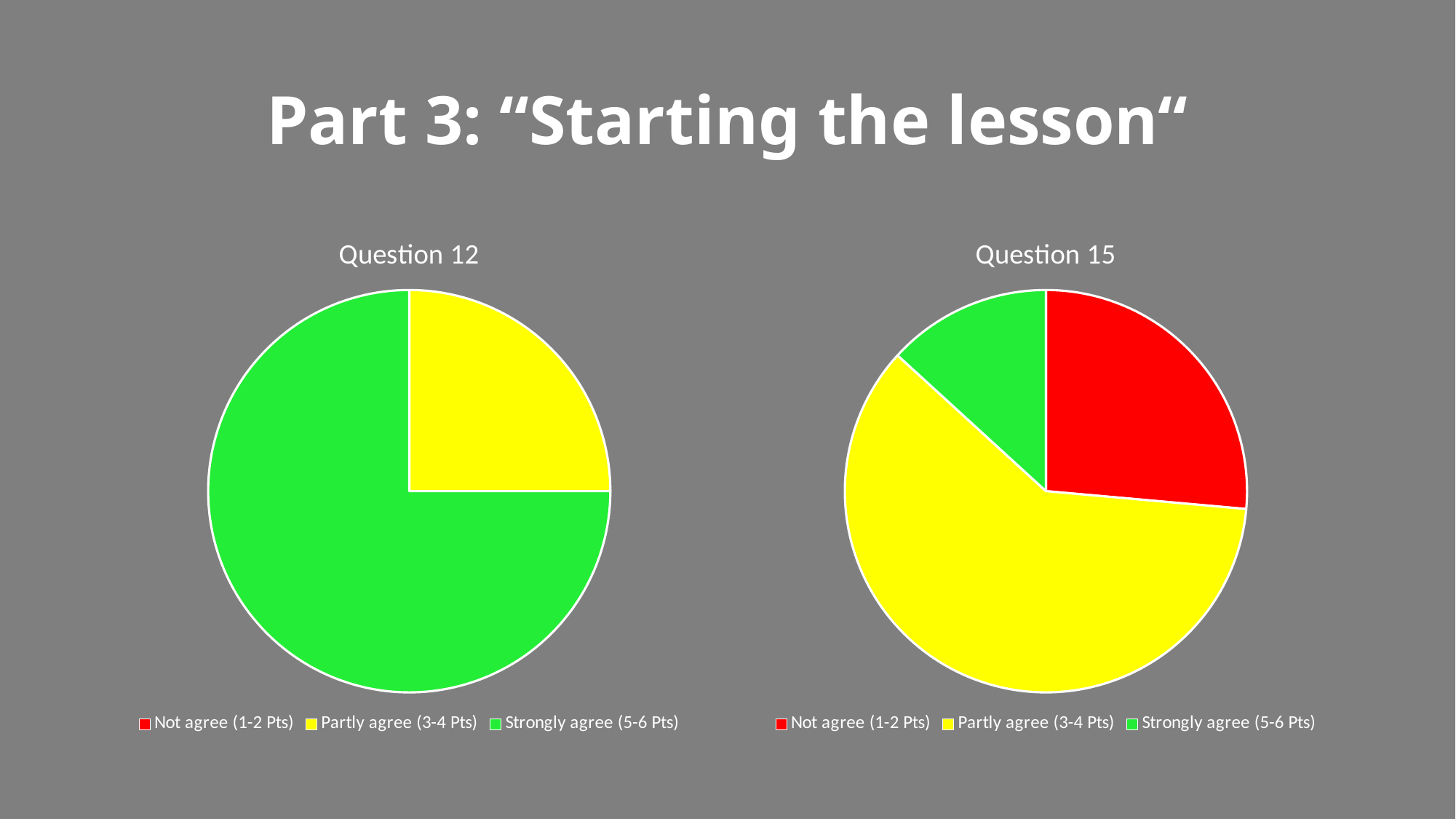
In the "Question 15" chart, which is larger: the slice for Not agree (1-2 Pts) or the slice for Strongly agree (5-6 Pts)? Not agree (1-2 Pts) What is the title of the slide? Part 3: "Starting the lesson" In the "Question 12" chart, which is larger: the slice for Partly agree (3-4 Pts) or the slice for Strongly agree (5-6 Pts)? Strongly agree (5-6 Pts) How many slices are visible in the "Question 15" pie chart? 3 What kind of chart is the "Question 15" chart? pie chart In the "Question 12" chart, which category has the largest slice? Strongly agree (5-6 Pts) In the "Question 15" chart, what colour represents Not agree (1-2 Pts)? red How many slices are visible in the "Question 12" pie chart? 2 What kind of chart is the "Question 12" chart? pie chart In the "Question 15" chart, which category has the smallest slice? Strongly agree (5-6 Pts) How many entries does the legend of the "Question 12" chart list? 3 In the "Question 15" chart, which category has the largest slice? Partly agree (3-4 Pts)